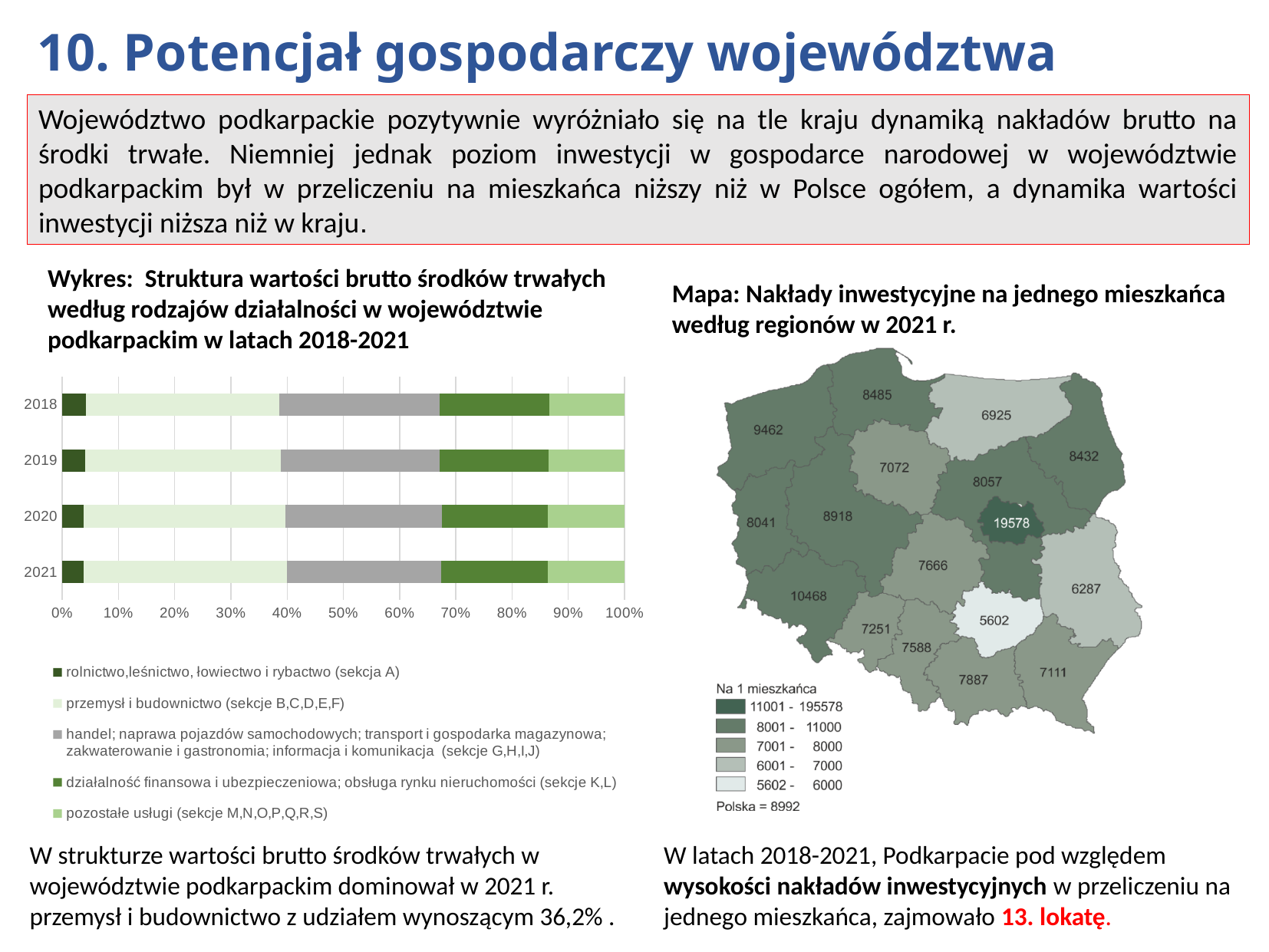
How many series does the legend of the stacked bar chart on the left list? 5 What kind of chart is the 'Struktura wartości brutto środków trwałych' chart on the left? stacked bar chart On the map on the right, which is larger: the region value 9462 or the region value 8485? 9462 On the stacked bar chart on the left, is the share of 'przemysł i budownictwo (sekcje B,C,D,E,F)' in 2021 greater or less than 30%? greater On the map on the right, what is the difference between the highest region value (19578) and the lowest region value (5602)? 13976 On the stacked bar chart on the left, is the share of 'rolnictwo, leśnictwo, łowiectwo i rybactwo (sekcja A)' in 2018 greater or less than 10%? less On the stacked bar chart on the left, which series is listed first in the legend? rolnictwo,leśnictwo, łowiectwo i rybactwo (sekcja A) On the stacked bar chart on the left, which series is listed last in the legend? pozostałe usługi (sekcje M,N,O,P,Q,R,S) How many years (categories) are shown on the stacked bar chart on the left? 4 On the map on the right, what value is given for Polska as a whole? 8992 On the map 'Nakłady inwestycyjne na jednego mieszkańca według regionów w 2021 r.', what is the lowest value printed on any region? 5602 On the map 'Nakłady inwestycyjne na jednego mieszkańca według regionów w 2021 r.', what is the highest value printed on any region? 19578